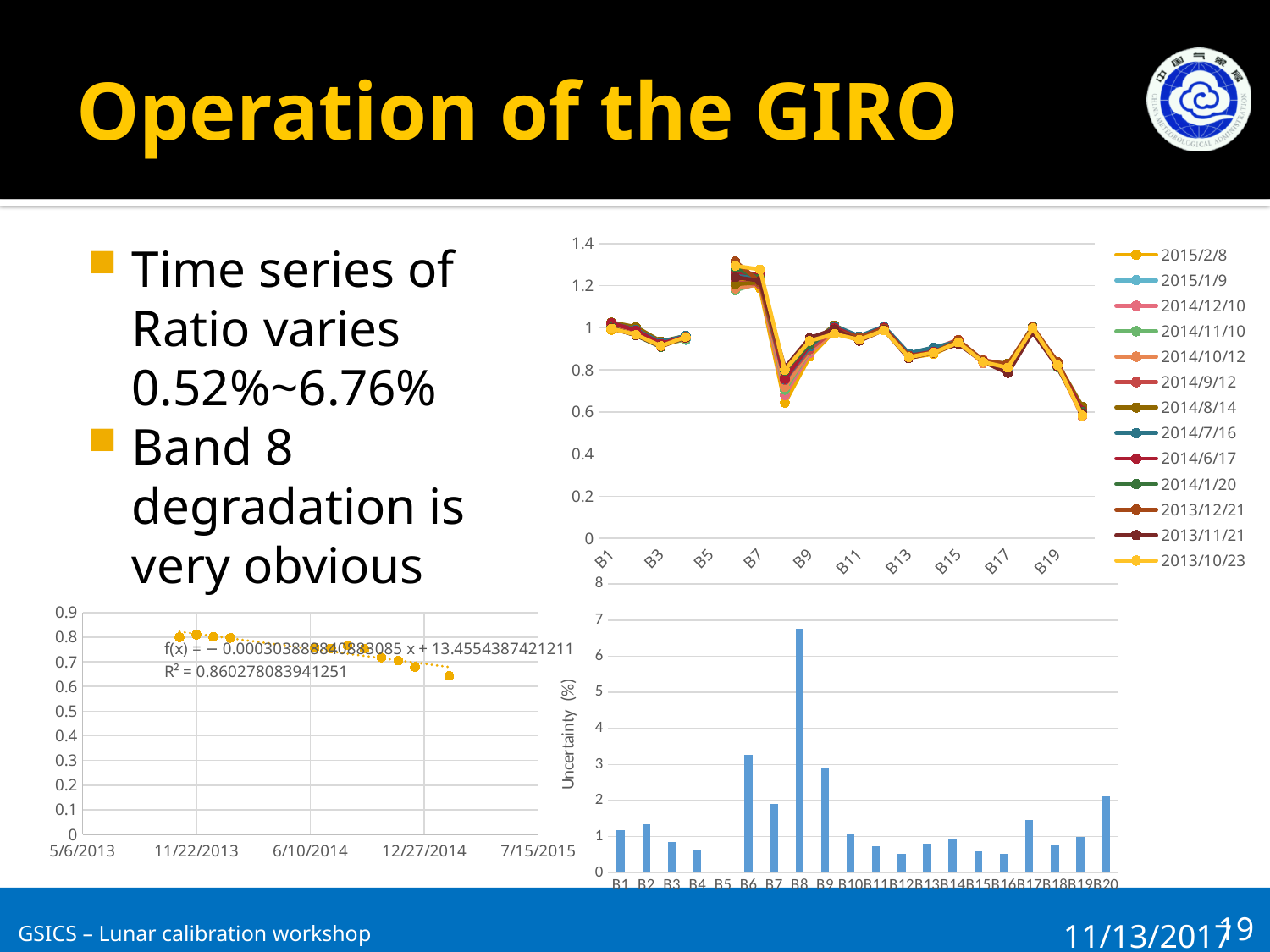
In the top-right line chart, is the value for B6 greater or less than 1? greater In the bottom-left chart with the trend line, what R² value is printed? R² = 0.860278083941251 What kind of chart is the bottom-right chart with the Uncertainty (%) axis? bar chart What kind of chart is the top-right chart showing values for bands B1 to B19? line chart In the bottom-right bar chart, which is larger, the value for B6 or the value for B9? B6 In the bottom-right bar chart, which band has the highest uncertainty? B8 In the top-right line chart, how many series does the legend list? 13 In the top-right line chart, which band has the highest values across the series? B6 What is the y-axis title of the bottom-right bar chart? Uncertainty (%) In the top-right line chart, is the value for B8 greater or less than 1? less In the bottom-right bar chart, is the value for B8 greater or less than 6? greater